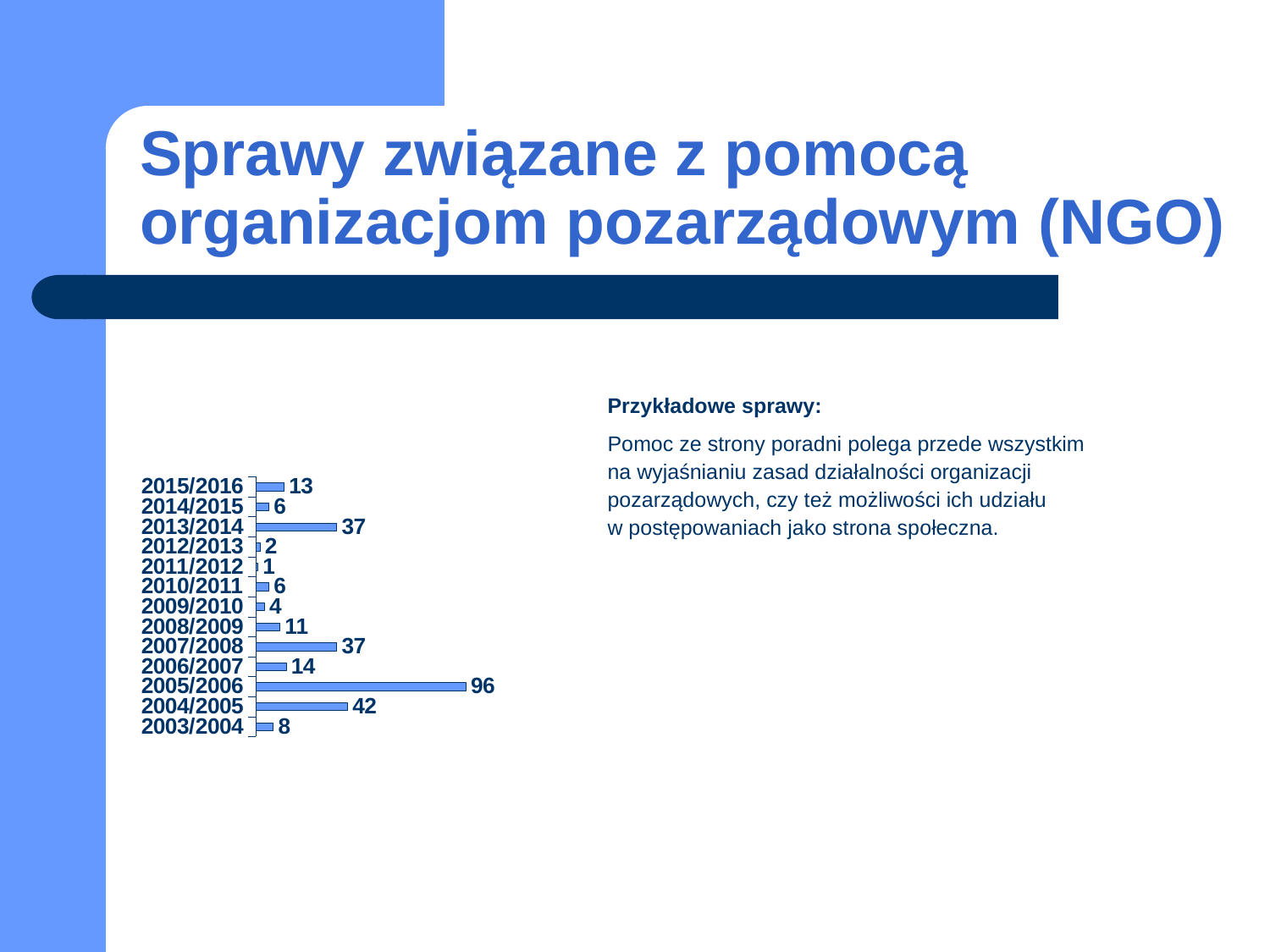
Which two categories share the value 37? 2013/2014 and 2007/2008 What kind of chart is shown on the slide? bar chart What is the value for 2012/2013? 2 Which category has the highest value? 2005/2006 What is the difference between the values for 2005/2006 and 2004/2005? 54 Which category has the lowest value? 2011/2012 What is the difference between the values for 2008/2009 and 2009/2010? 7 What is the value for 2003/2004? 8 What is the value for 2005/2006? 96 Which is larger, the value for 2015/2016 or the value for 2006/2007? 2006/2007 What is the value for 2013/2014? 37 How many categories does the chart show? 13